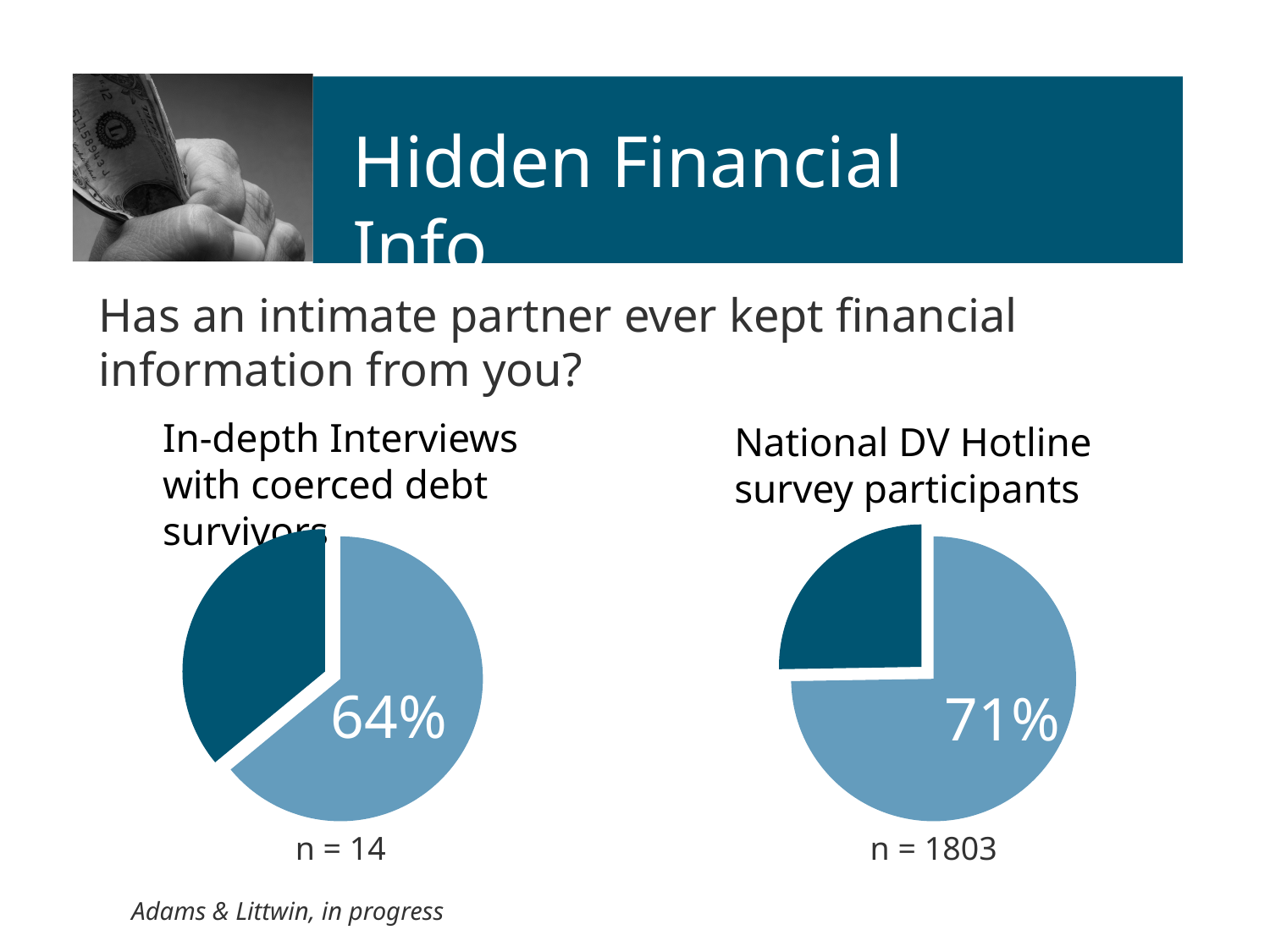
In the In-depth Interviews pie chart, what share of the pie does the labeled light-blue slice represent? 64% What is the sample size (n) shown under the National DV Hotline pie chart? n = 1803 What is the sample size (n) shown under the In-depth Interviews pie chart? n = 14 What type of chart is used for the In-depth Interviews with coerced debt survivors data? Pie chart How many slices does the National DV Hotline pie chart have? 2 What type of chart is used for the National DV Hotline survey participants data? Pie chart Which chart shows the higher labeled percentage, the In-depth Interviews chart or the National DV Hotline chart? National DV Hotline survey participants In the National DV Hotline pie chart, what share of the pie does the labeled light-blue slice represent? 71% In the pie chart for National DV Hotline survey participants, what percentage is shown for the large light-blue slice? 71% How many slices does the In-depth Interviews pie chart have? 2 What is the difference in percentage points between the labeled value in the National DV Hotline chart (71%) and the In-depth Interviews chart (64%)? 7 percentage points In the pie chart for In-depth Interviews with coerced debt survivors, what percentage is shown for the large light-blue slice? 64%